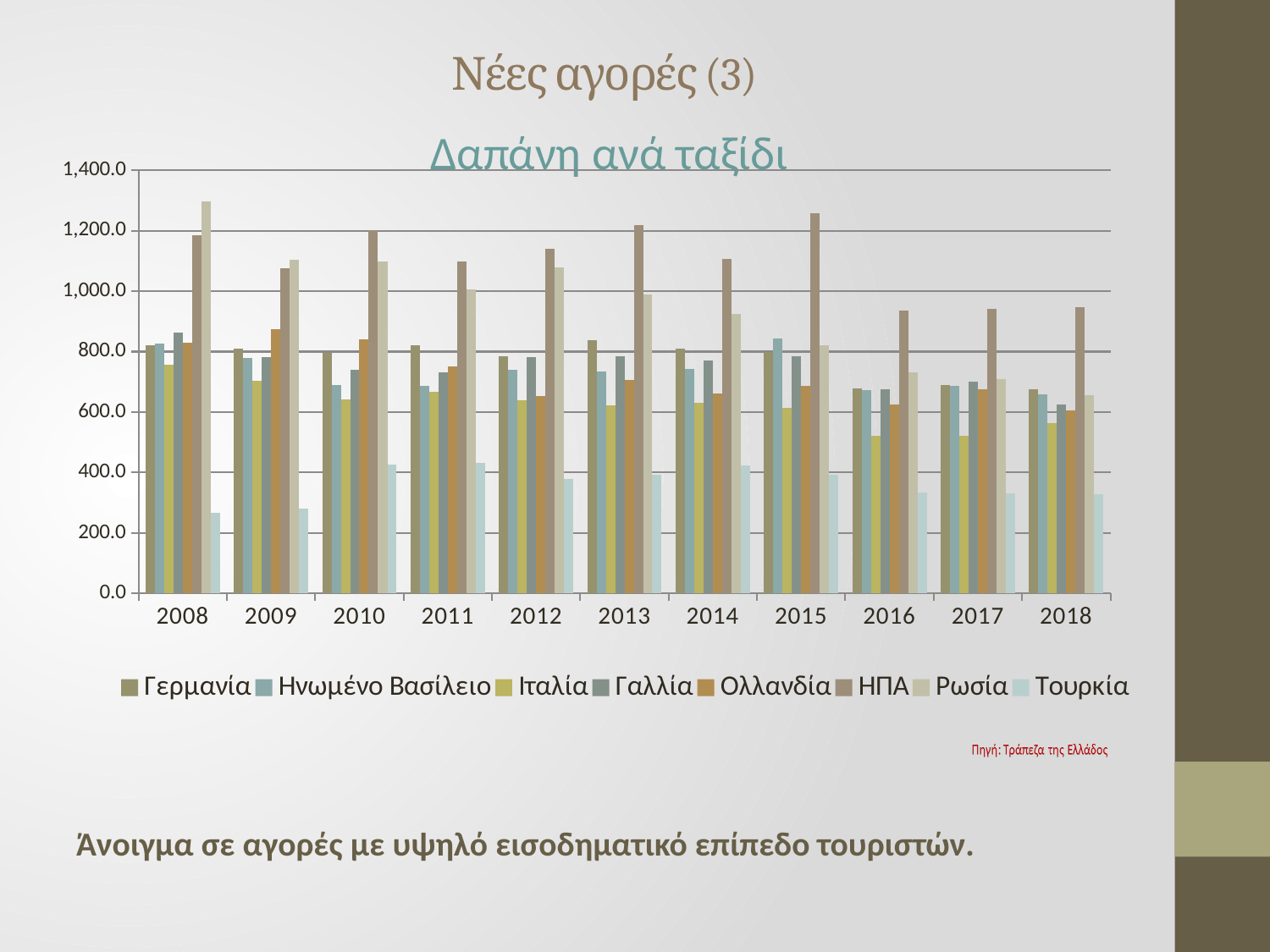
What is the title of the chart? Δαπάνη ανά ταξίδι Which series has the lowest value in 2018? Τουρκία How many series does the chart's legend list? 8 How many years are shown on the x axis of the chart? 11 Is the value for Ρωσία in 2008 greater or less than 1,200.0? greater Is the value for ΗΠΑ in 2018 greater or less than 1,000.0? less In 2015, which is larger: the value for ΗΠΑ or the value for Ρωσία? ΗΠΑ From 2013 to 2018, do the values for Ρωσία rise or fall? fall Which series has the highest value in 2008? Ρωσία In which year is the value for Ρωσία highest? 2008 What kind of chart is shown on the slide? bar chart Which series has the lowest value in 2008? Τουρκία